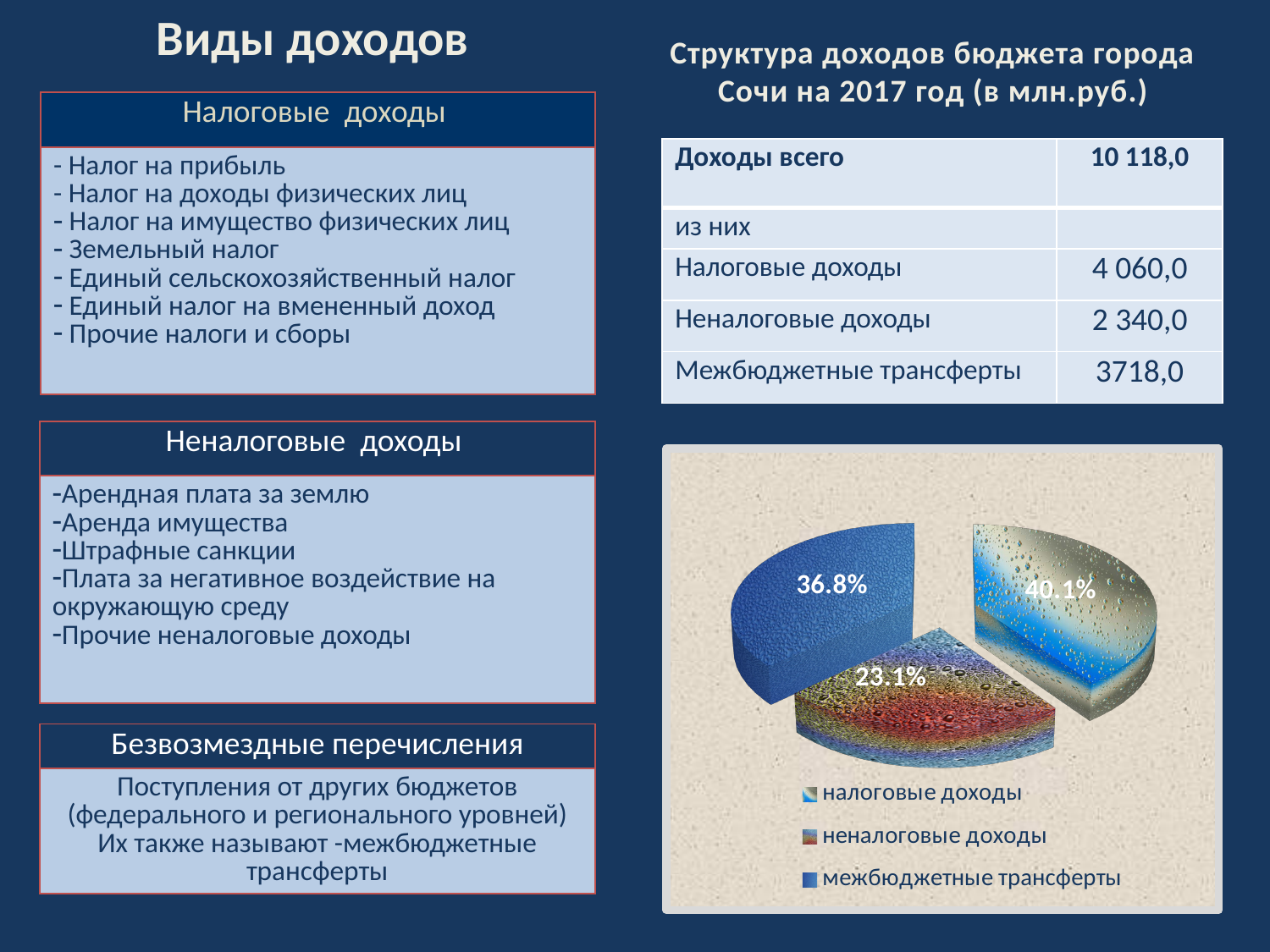
What kind of chart is shown on the slide? pie chart Which is larger in the pie chart: налоговые доходы or межбюджетные трансферты? налоговые доходы What is the difference in percentage points between the межбюджетные трансферты slice and the неналоговые доходы slice? 13.7 What is the difference in percentage points between the налоговые доходы slice and the неналоговые доходы slice? 17.0 Which legend entry is shown in solid blue in the pie chart? межбюджетные трансферты What share of the pie does неналоговые доходы have? 23.1% How many entries does the pie chart's legend list? 3 Which slice of the pie chart is the largest? налоговые доходы What share of the pie does межбюджетные трансферты have? 36.8% How many slices does the pie chart have? 3 Which slice of the pie chart is the smallest? неналоговые доходы What share of the pie does налоговые доходы have? 40.1%